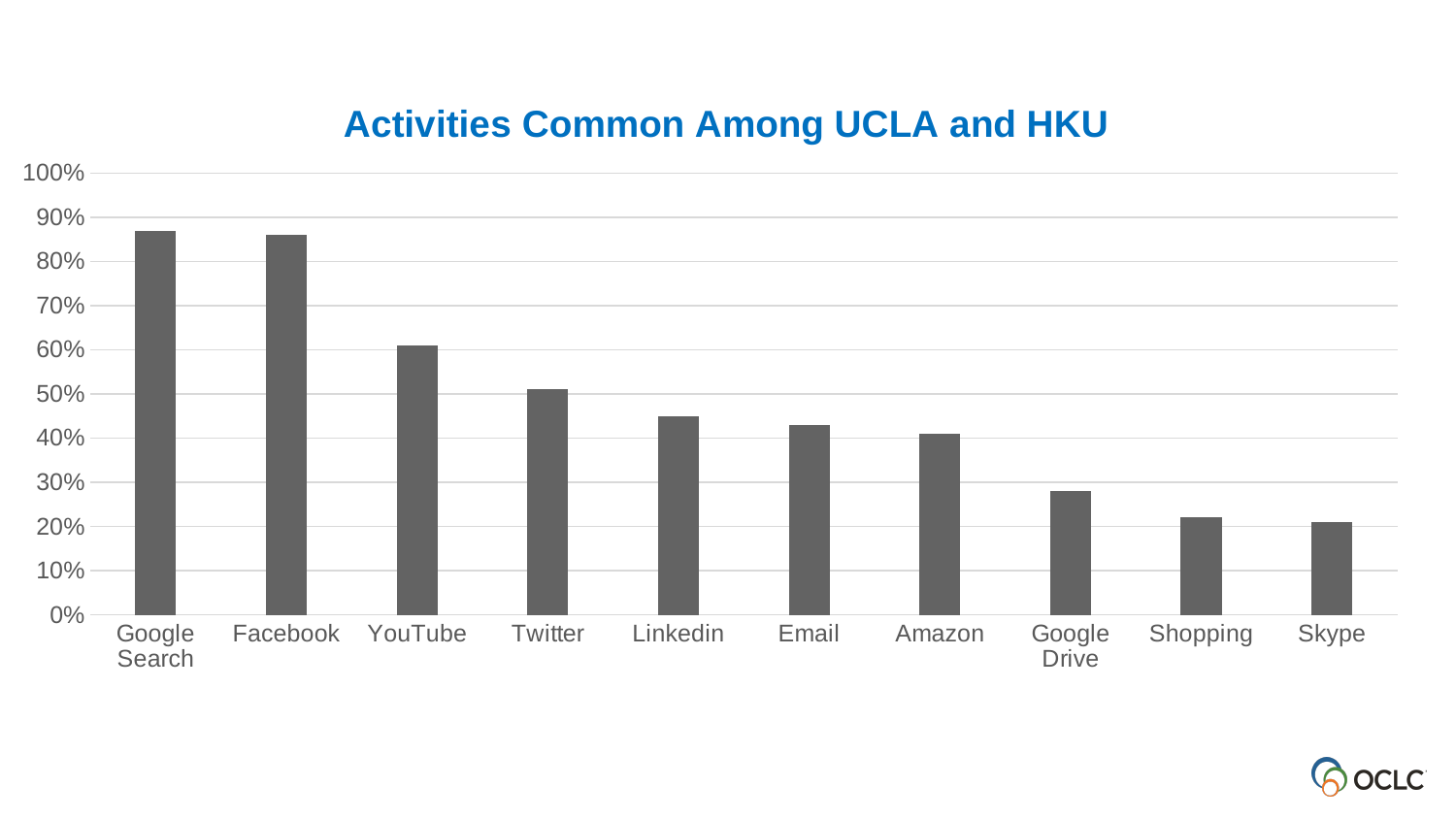
Is the value for Linkedin greater or less than 40%? greater Is the value for Google Search greater or less than 80%? greater Which has a higher value, YouTube or Twitter? YouTube Do the values rise or fall moving from left to right along the x axis? fall Is the value for Google Drive greater or less than 30%? less Which has a higher value, Facebook or YouTube? Facebook How many activities are shown on the x axis of the chart? 10 What is the title of the chart? Activities Common Among UCLA and HKU What type of chart is shown on the slide? bar chart Which has a higher value, Google Drive or Amazon? Amazon